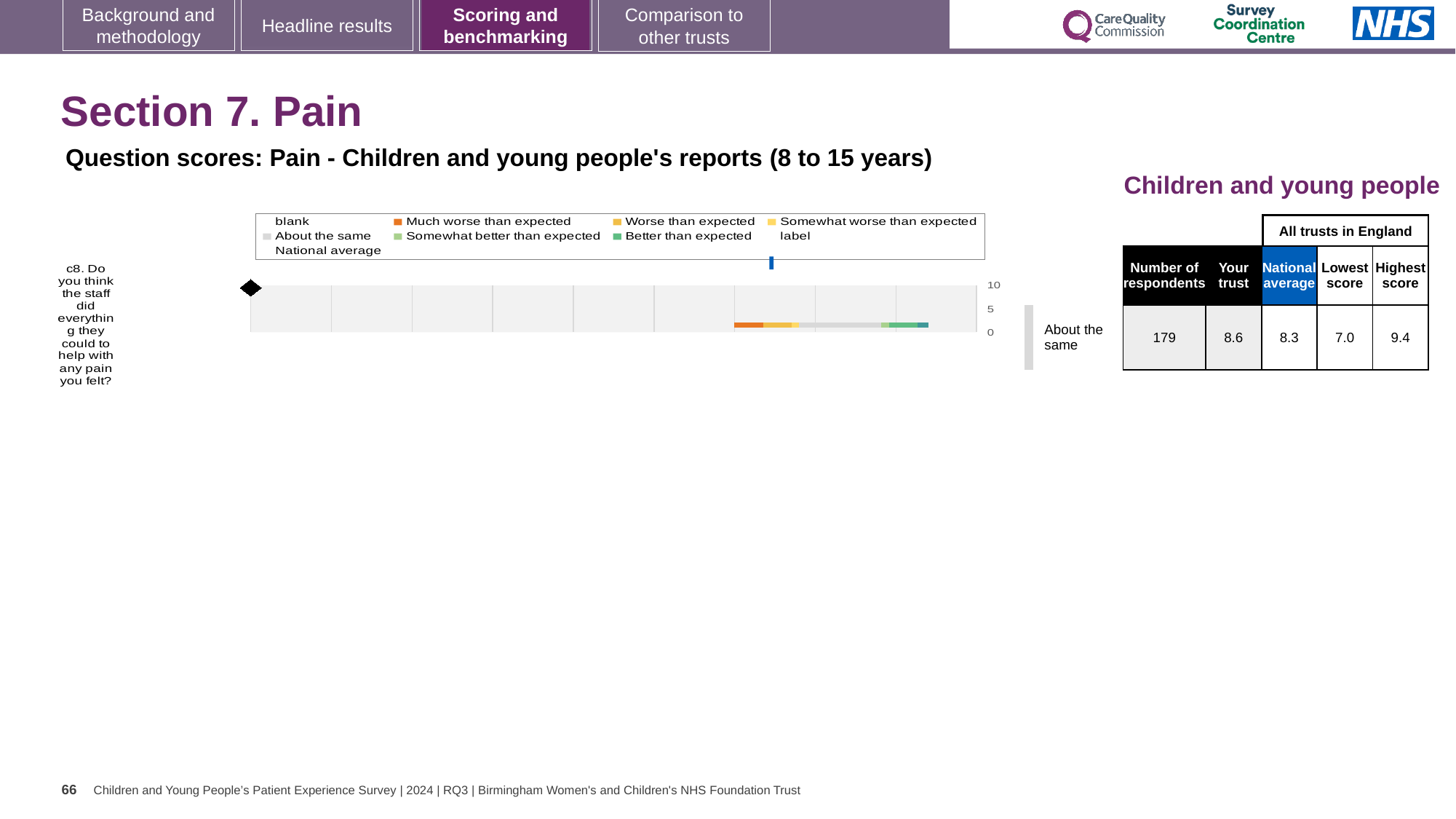
In the table beside the chart, what is the Lowest score among all trusts in England? 7.0 In the table beside the chart, what is the National average score? 8.3 Which question is plotted on the chart? c8. Do you think the staff did everything they could to help with any pain you felt? In the table beside the chart, what is the Highest score among all trusts in England? 9.4 In the table beside the chart, how many respondents are listed? 179 What is the highest tick value shown on the chart's score axis? 10 How many entries does the chart legend list? 9 How many question categories are plotted on the chart? 1 Which is larger in the table beside the chart, the Your trust score or the National average? Your trust In the table beside the chart, what is the 'Your trust' score for the 'About the same' row? 8.6 What kind of chart is shown on the slide? bar chart What is the difference between the Highest score and the Lowest score in the table beside the chart? 2.4